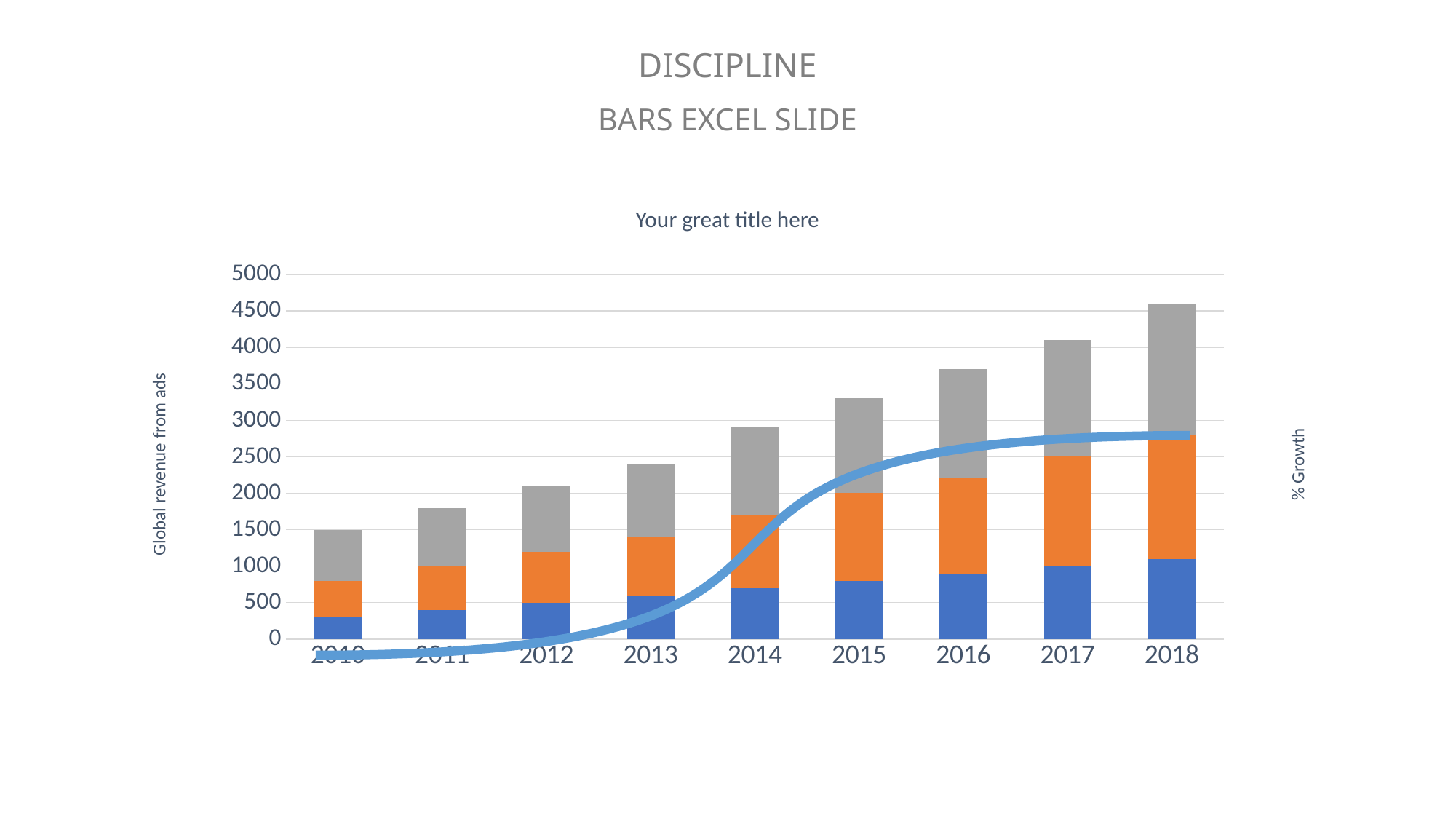
How many years are shown on the x axis of the chart? 9 What is the label on the left vertical axis of the chart? Global revenue from ads Which year has the larger stacked bar total, 2013 or 2015? 2015 Is the total stacked bar value for 2016 greater or less than 3500? greater Which year has the tallest stacked bar? 2018 What is the title of the chart? Your great title here What is the total stacked bar value for 2010? 1500 What kind of chart is shown on the slide? Stacked bar chart with a line Do the stacked bar totals rise or fall from 2010 to 2018? Rise Which year has the shortest stacked bar? 2010 Is the total stacked bar value for 2014 greater or less than 3000? less Is the total stacked bar value for 2018 greater or less than 4500? greater